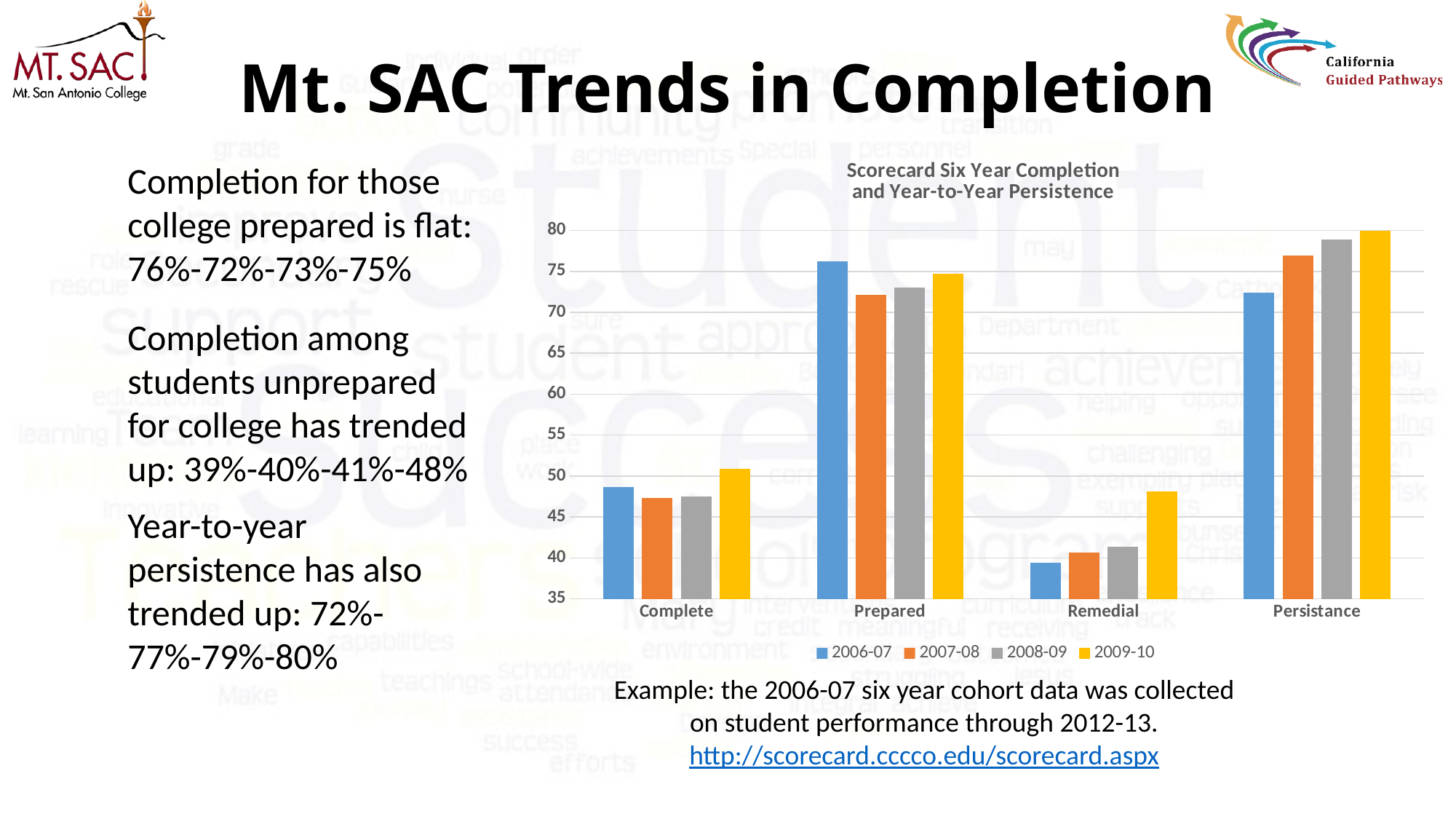
What is the title of the chart? Scorecard Six Year Completion and Year-to-Year Persistence Which is larger: Persistence in 2006-07 or Persistence in 2007-08? Persistence in 2007-08 Is the value for Remedial in 2009-10 greater or less than 45? greater How many categories are shown on the x axis of the chart? 4 Which colour represents the 2009-10 series in the chart? yellow What kind of chart is shown on the slide? bar chart Which category has the tallest bar in the chart? Persistance Is the value for Complete in 2006-07 greater or less than 50? less How many series does the chart legend list? 4 Which category has the lowest bar in the chart? Remedial Is the value for Persistence in 2006-07 greater or less than 70? greater Do the Persistence values rise or fall from 2006-07 to 2009-10? rise